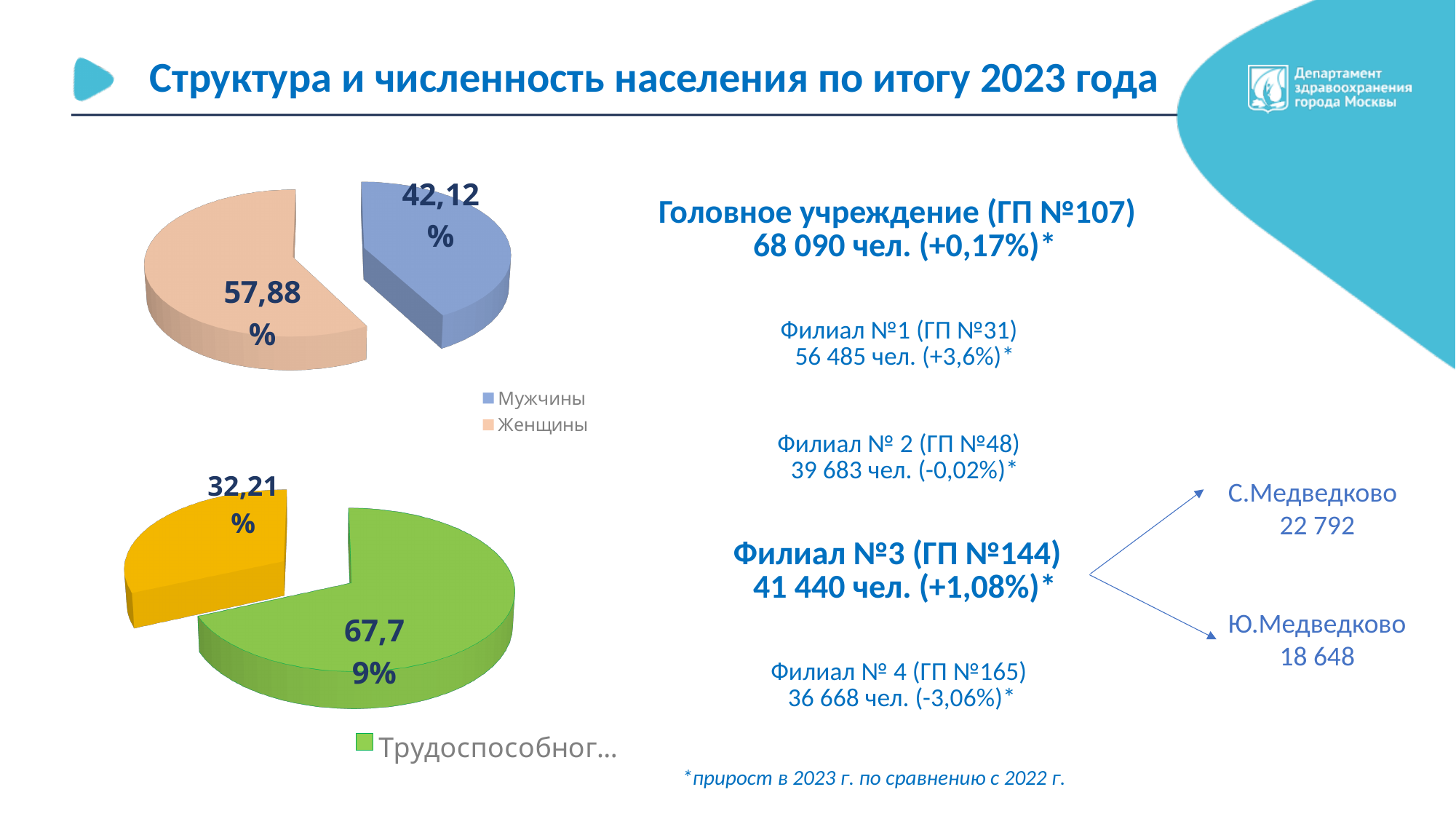
In the bottom pie chart, which slice is larger, the green one or the yellow one? the green one In the top pie chart, what is the difference in percentage points between the Женщины and Мужчины slices? 15,76 What type of chart is the top chart on the left of the slide? pie chart In the top pie chart, what colour is the Мужчины slice? blue In the top pie chart, which category has the larger slice, Мужчины or Женщины? Женщины How many slices does the top pie chart have? 2 In the top pie chart, what share is shown for Женщины? 57,88% In the bottom pie chart, what share is shown for the green slice (Трудоспособног…)? 67,79% In the bottom pie chart, what share is shown for the yellow slice? 32,21% In the top pie chart, what share is shown for Мужчины? 42,12% What type of chart is the bottom chart on the left of the slide? pie chart How many entries does the legend of the top pie chart list? 2